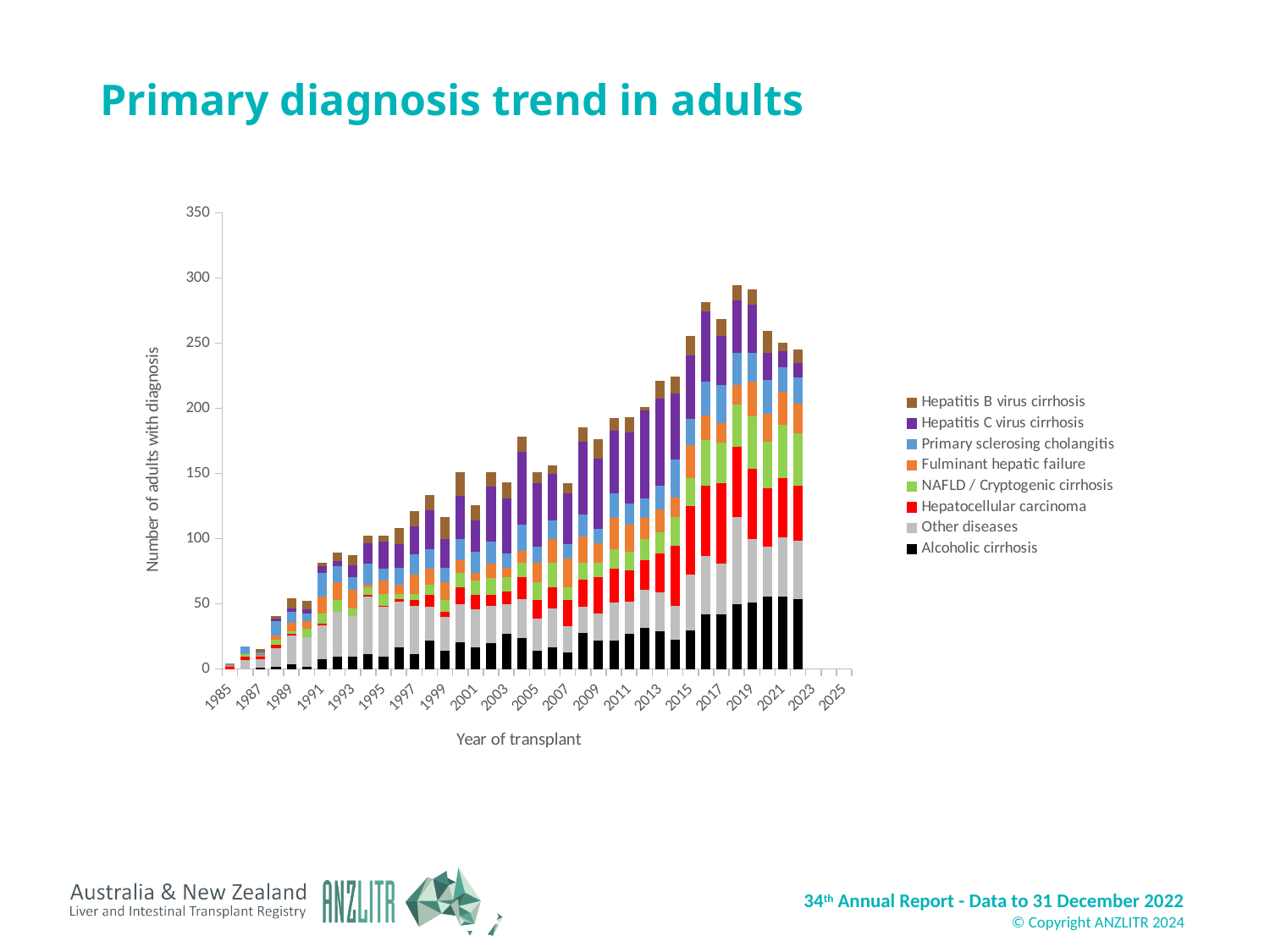
Which year has the lowest total number of adults with a diagnosis? 1985 Which year has the larger total number of adults, 2016 or 2014? 2016 Is the total number of adults for 2018 greater or less than 250? greater Is the total number of adults for 2010 greater or less than 200? less What is the label of the vertical axis? Number of adults with diagnosis What kind of chart is shown on the slide? stacked bar chart Is the total number of adults for 2014 greater or less than 250? less How many series does the legend list? 8 Do the total numbers of adults generally rise or fall from 1985 to 2018? rise What is the title of the chart? Primary diagnosis trend in adults